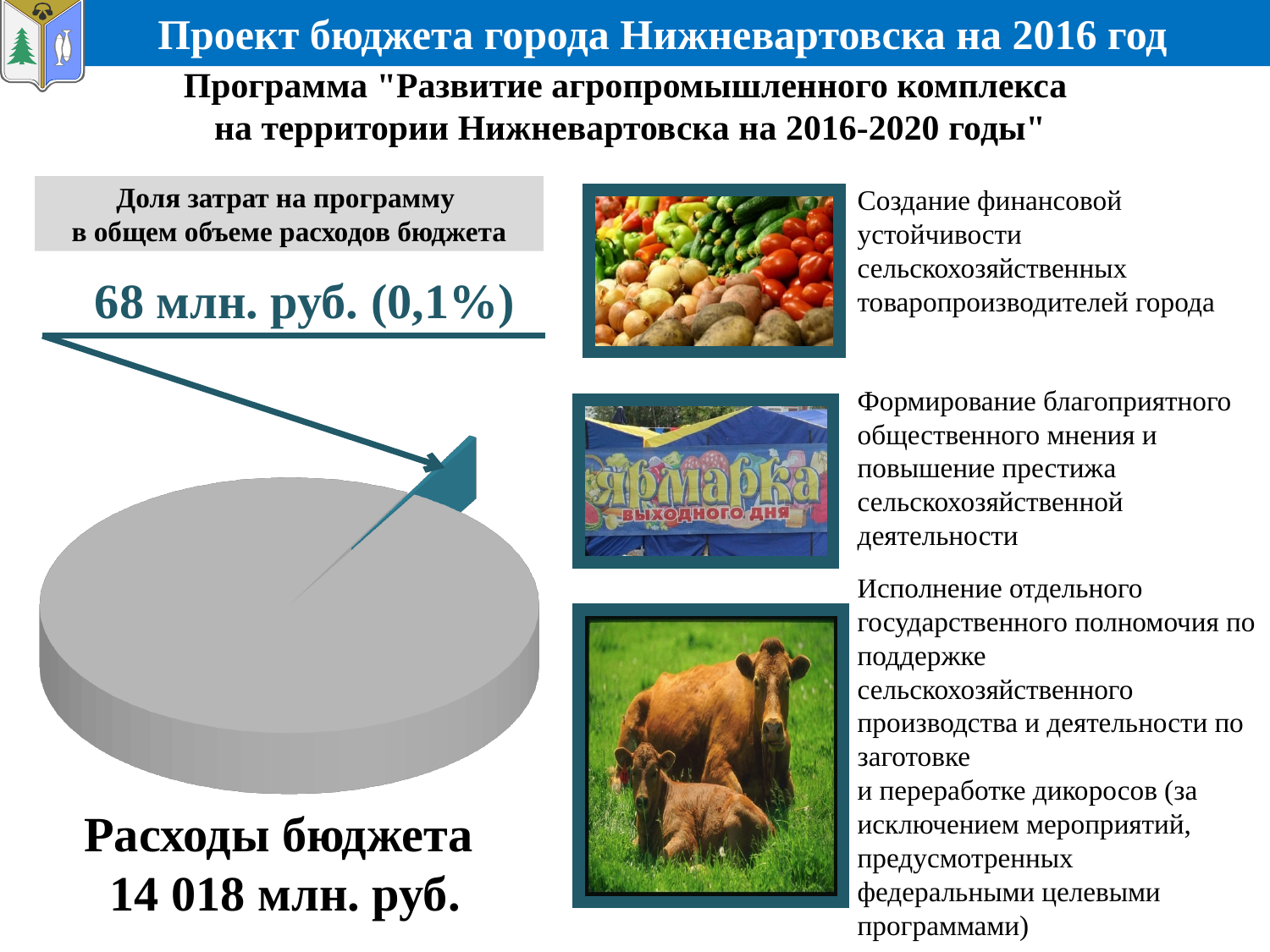
Which slice of the pie chart is larger: the program expenditure slice or the rest of the budget expenditures? The rest of the budget expenditures Is the program expenditure of 68 млн. руб. greater or less than 100 млн. руб.? less What colour is the small pulled-out slice of the pie chart representing the program expenditure? Teal (dark blue-green) What kind of chart is shown on the left side of the slide? Pie chart What is the title of the box above the pie chart describing what the chart shows? Доля затрат на программу в общем объеме расходов бюджета Which slice of the pie chart is the smallest? The program expenditure slice (68 млн. руб.) What is the total budget expenditure (Расходы бюджета) shown below the pie chart? 14 018 млн. руб. What is the value of the program expenditure shown for the small slice of the pie chart? 68 млн. руб. What share of total budget expenditures does the program (the small slice) represent according to the slide? 0,1% How many slices does the pie chart on the slide have? 2